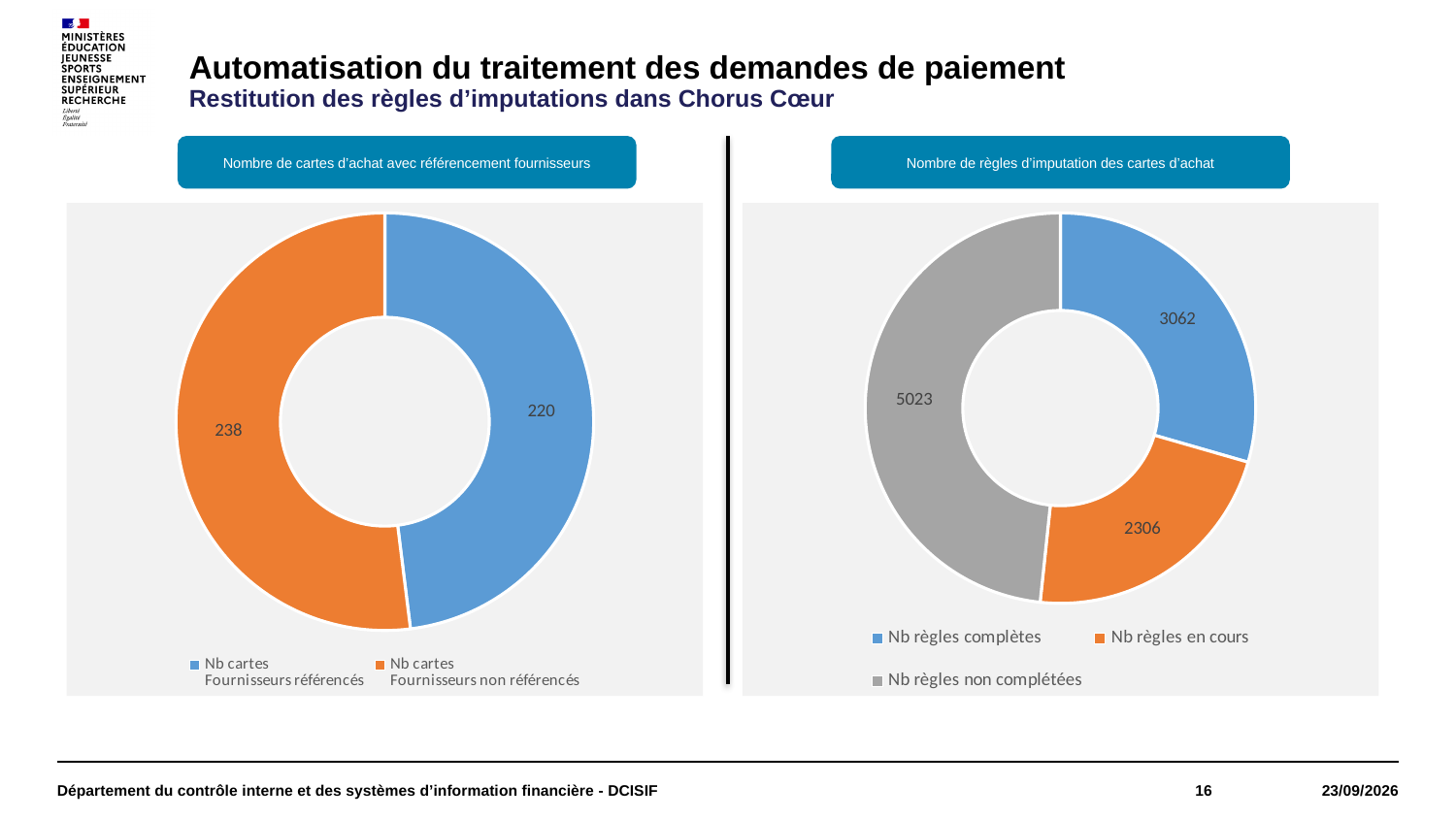
In the chart titled 'Nombre de cartes d'achat avec référencement fournisseurs', what is the value for 'Nb cartes Fournisseurs non référencés'? 238 In the right chart, what is the difference between 'Nb règles non complétées' and 'Nb règles complètes'? 1961 In the right chart, which category has the highest value? Nb règles non complétées In the right chart, is the value for 'Nb règles complètes' larger or smaller than the value for 'Nb règles en cours'? larger In the left chart, which category has the larger value? Nb cartes Fournisseurs non référencés In the chart titled 'Nombre de règles d'imputation des cartes d'achat', what is the value for 'Nb règles complètes'? 3062 What kind of chart is used on the left side of the slide? Pie (doughnut) chart In the right chart, which category has the lowest value? Nb règles en cours In the chart titled 'Nombre de règles d'imputation des cartes d'achat', what is the value for 'Nb règles en cours'? 2306 How many categories does the legend of the right chart list? 3 In the chart titled 'Nombre de cartes d'achat avec référencement fournisseurs', what is the value for 'Nb cartes Fournisseurs référencés'? 220 In the left chart, what is the difference between 'Nb cartes Fournisseurs non référencés' and 'Nb cartes Fournisseurs référencés'? 18